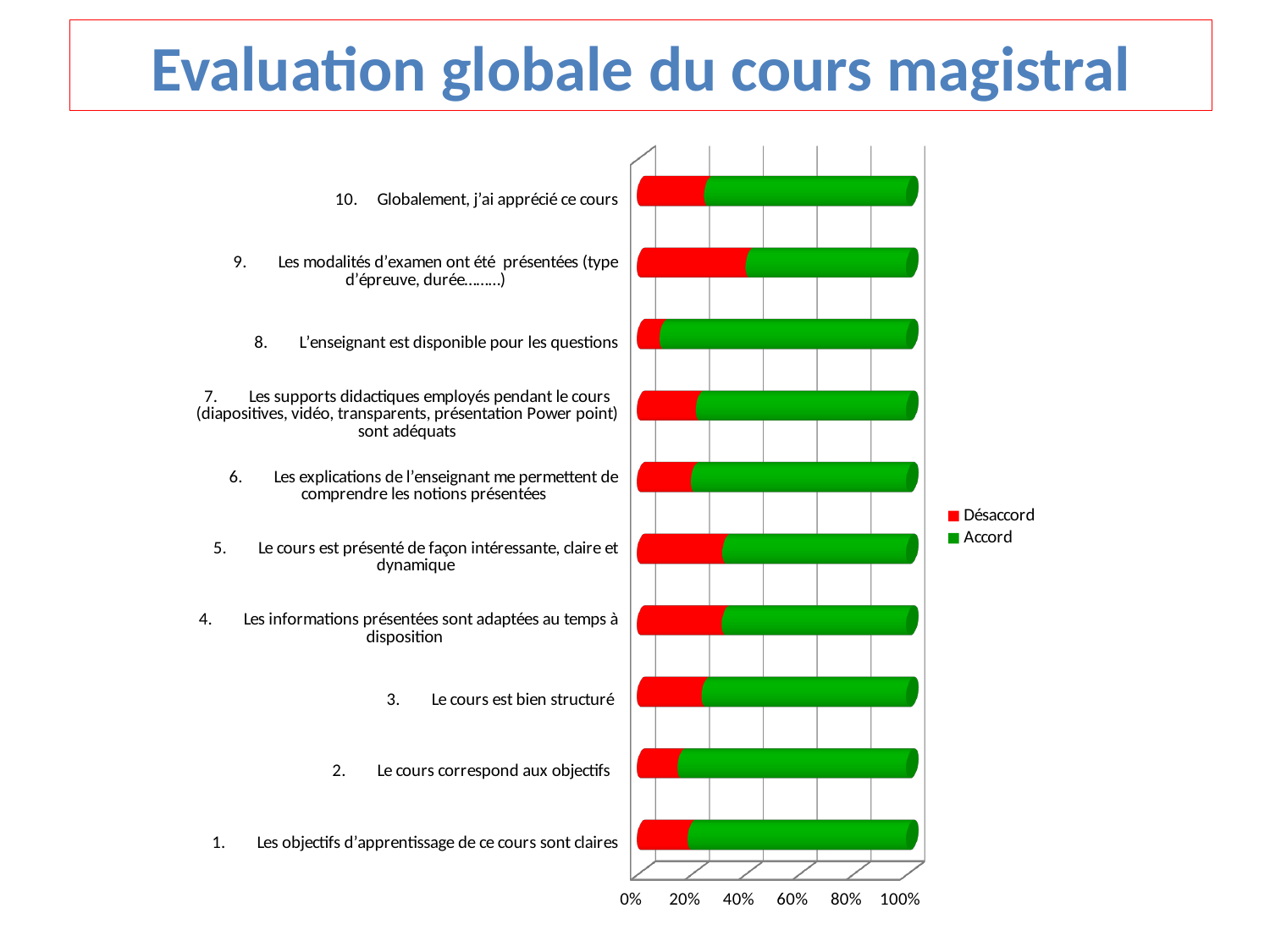
Is the 'Désaccord' value for statement 9 (Les modalités d'examen ont été présentées) greater or less than 20%? greater Is the 'Désaccord' value for statement 8 (L'enseignant est disponible pour les questions) greater or less than 20%? less Which statement has the largest 'Désaccord' share? 9. Les modalités d'examen ont été présentées (type d'épreuve, durée………) What is the title of the slide containing the chart? Evaluation globale du cours magistral What kind of chart is shown on the slide? Stacked bar chart Which has the larger 'Accord' share: statement 8 (L'enseignant est disponible pour les questions) or statement 9 (Les modalités d'examen ont été présentées)? Statement 8 Which has the larger 'Désaccord' share: statement 9 (Les modalités d'examen ont été présentées) or statement 2 (Le cours correspond aux objectifs)? Statement 9 How many statements (categories) are listed on the chart? 10 Which colour represents the 'Désaccord' series in the chart? Red How many series does the legend list? 2 Which statement has the smallest 'Désaccord' share? 8. L'enseignant est disponible pour les questions Is the 'Accord' value for statement 8 (L'enseignant est disponible pour les questions) greater or less than 80%? greater